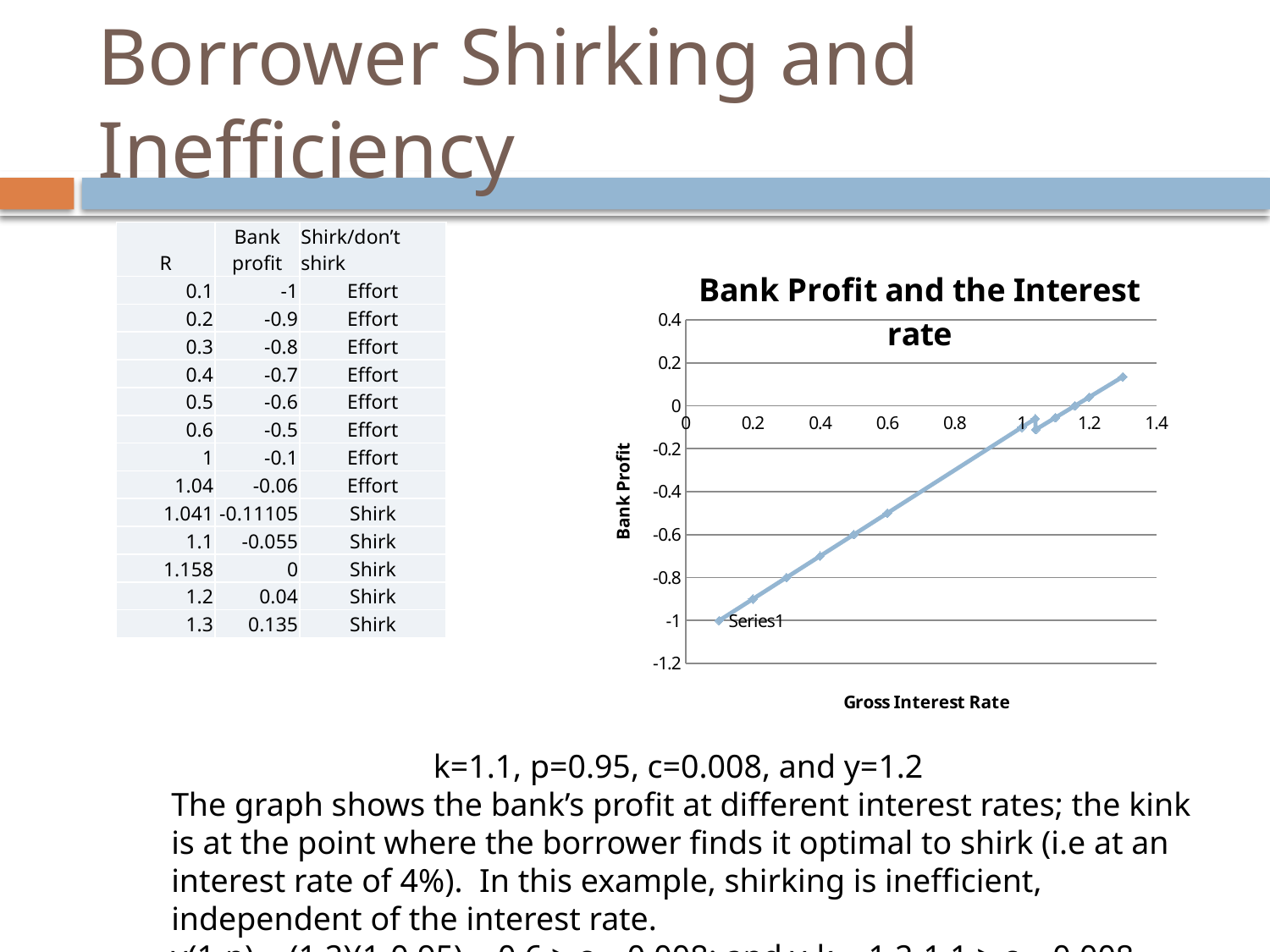
What type of chart is shown on the slide? line chart What is the label of the horizontal axis of the chart? Gross Interest Rate What is the bank profit plotted at a gross interest rate of 0.1? -1 At which gross interest rate is the plotted bank profit lowest? 0.1 Is the bank profit at a gross interest rate of 0.5 greater or less than -0.4? less What is the bank profit plotted at a gross interest rate of 1.3? 0.135 What is the difference between the bank profit at a gross interest rate of 1.3 and at 0.1? 1.135 What is the title of the chart? Bank Profit and the Interest rate Does the bank profit rise or fall as the gross interest rate increases along the x axis? rise Which is larger, the bank profit at a gross interest rate of 0.6 or at 0.4? 0.6 At which gross interest rate is the plotted bank profit highest? 1.3